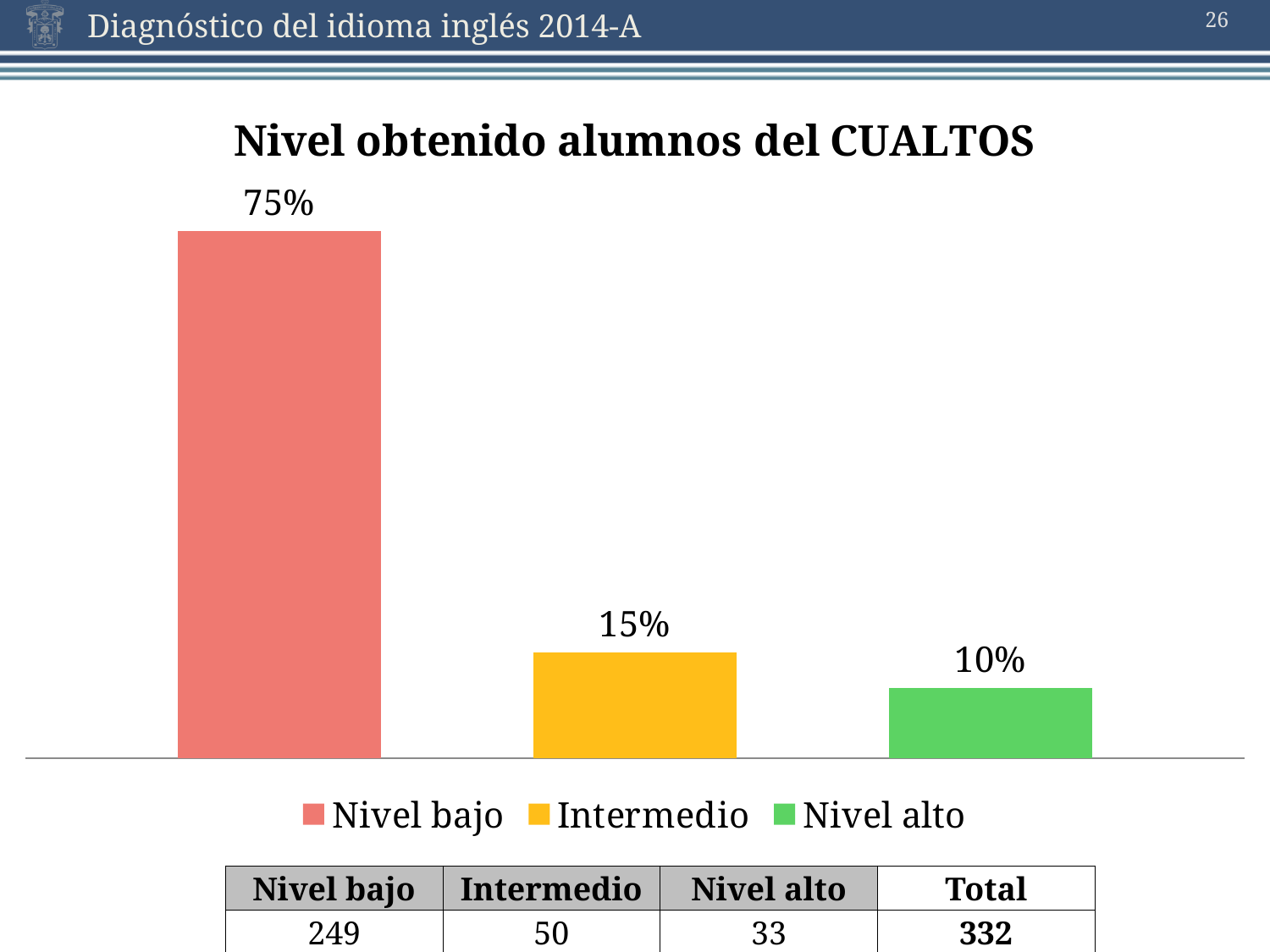
What is the difference in percentage points between Intermedio and Nivel alto? 5 Which is larger, the percentage for Intermedio or for Nivel alto? Intermedio How many entries does the legend list? 3 What percentage is shown for Nivel alto? 10% What percentage is shown for Nivel bajo? 75% What is the difference in percentage points between Nivel bajo and Intermedio? 60 Which level has the highest percentage? Nivel bajo What is the title of the chart? Nivel obtenido alumnos del CUALTOS How many bars are plotted in the chart? 3 What percentage is shown for Intermedio? 15% Which level has the lowest percentage? Nivel alto What type of chart is shown? Bar chart